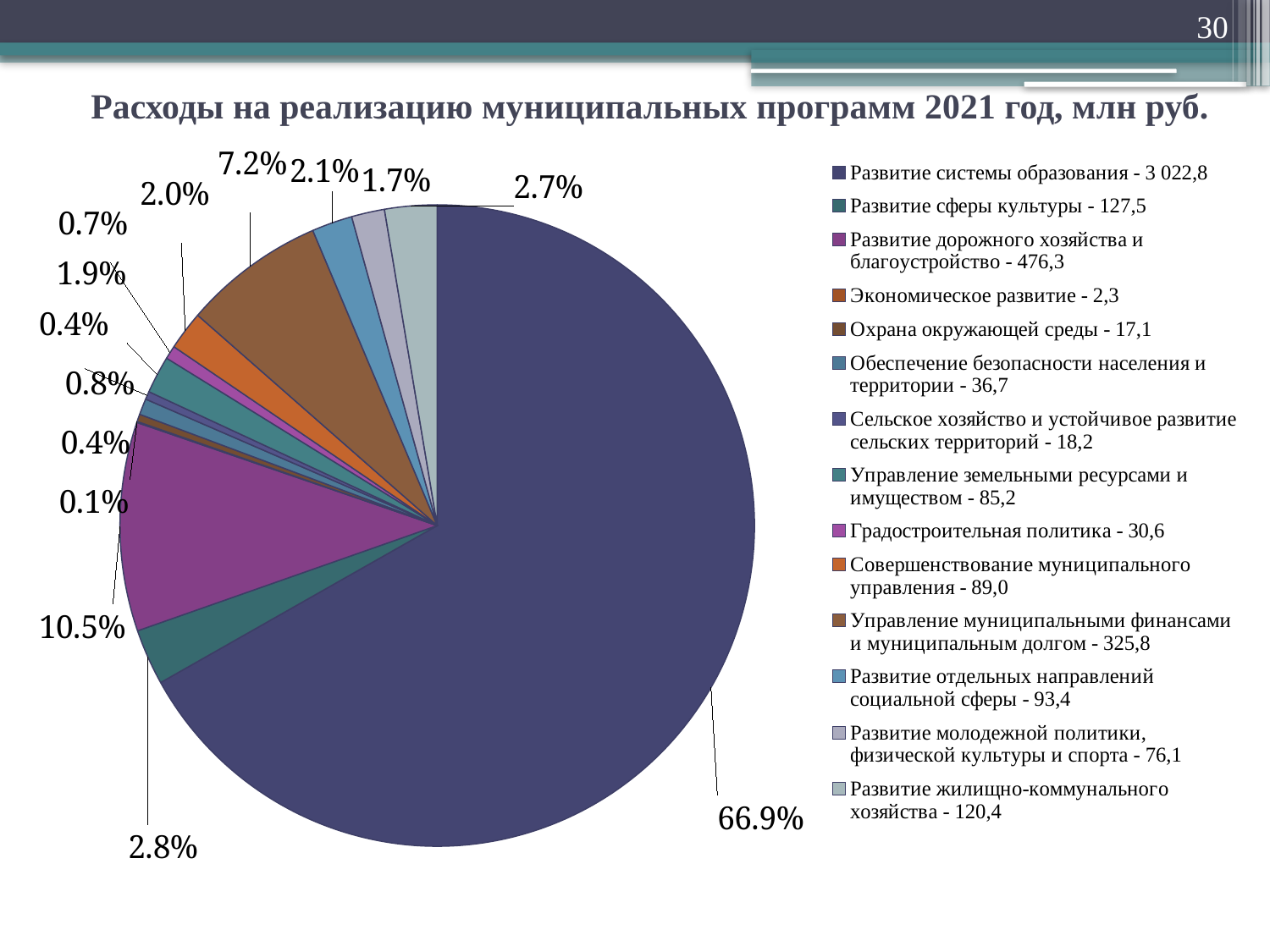
What is the difference between the values for "Развитие дорожного хозяйства и благоустройство" (476,3) and "Управление муниципальными финансами и муниципальным долгом" (325,8)? 150,5 What value in million rubles is given in the legend for "Развитие жилищно-коммунального хозяйства"? 120,4 How many categories does the legend of the pie chart list? 14 Which category has the smallest share of the pie? Экономическое развитие Which is larger: the value for "Развитие сферы культуры" or the value for "Развитие молодежной политики, физической культуры и спорта"? Развитие сферы культуры Which category has the largest share of the pie? Развитие системы образования What kind of chart is shown on the slide? pie chart What share of the pie does "Развитие дорожного хозяйства и благоустройство" take? 10.5% What is the title of the chart? Расходы на реализацию муниципальных программ 2021 год, млн руб. What value in million rubles is given in the legend for "Управление муниципальными финансами и муниципальным долгом"? 325,8 What share of the pie does "Развитие системы образования" take? 66.9% What share of the pie does "Управление муниципальными финансами и муниципальным долгом" take? 7.2%